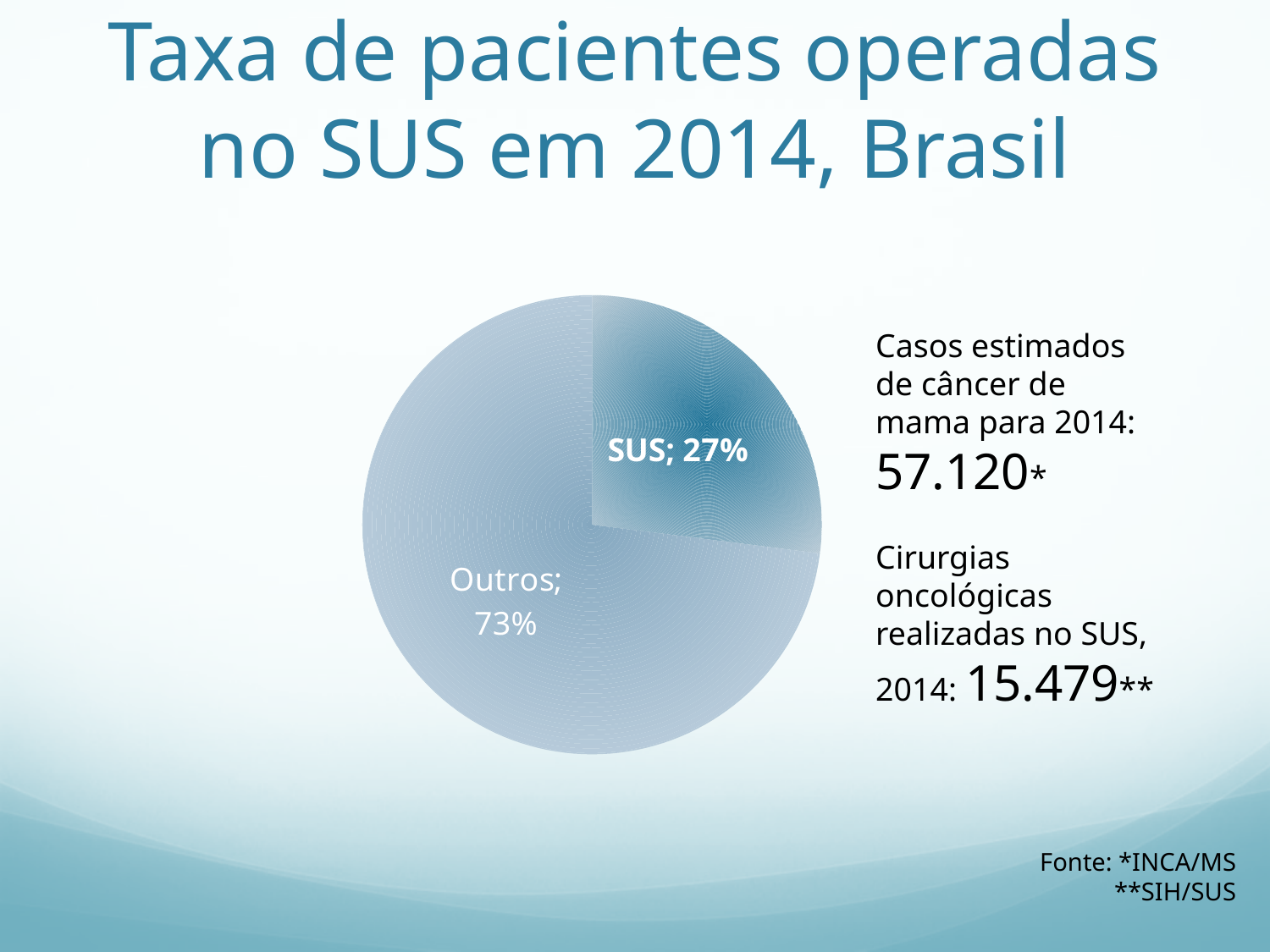
Which slice of the pie is the largest? Outros What share of the pie does the SUS slice represent? 27% What kind of chart is shown on the slide? pie chart Which slice of the pie is shown in the darker blue colour? SUS What is the difference in percentage points between the Outros slice and the SUS slice? 46 What is the title of the slide containing the pie chart? Taxa de pacientes operadas no SUS em 2014, Brasil Is the value for SUS greater or less than 50%? less What share of the pie does the Outros slice represent? 73% Which slice of the pie is the smallest? SUS How many slices does the pie chart have? 2 Which is larger, the SUS slice or the Outros slice? Outros